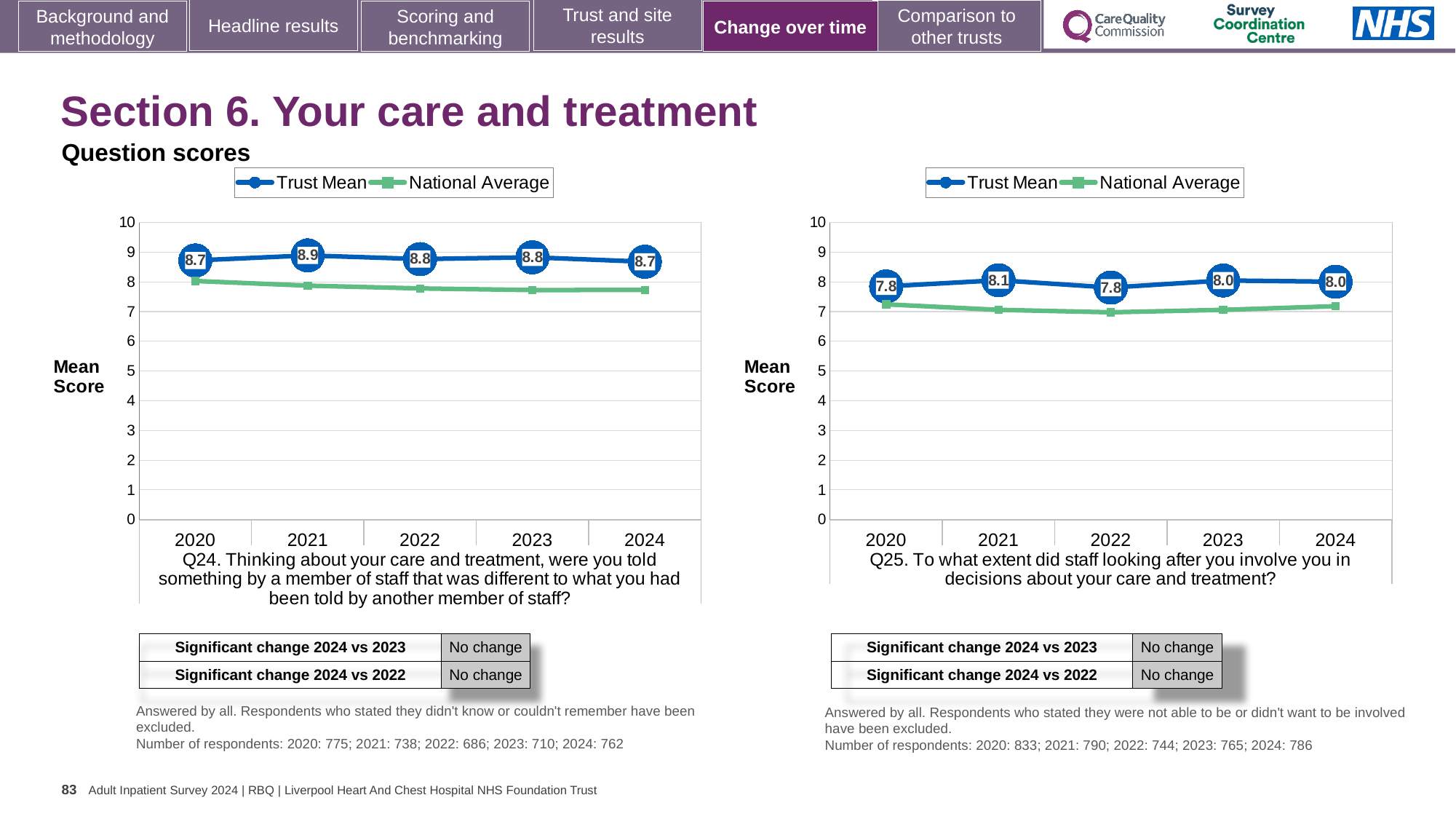
In the Q25 chart on the right, what is the difference between the Trust Mean scores for 2021 and 2020? 0.3 What kind of chart is the Q24 chart on the left? Line chart In the Q24 chart on the left, is the National Average value for 2024 greater or less than 8? less In the Q24 chart on the left, what is the Trust Mean score for 2021? 8.9 In the Q25 chart on the right, is the Trust Mean score higher in 2021 or in 2022? 2021 In the Q25 chart on the right, is the National Average value for 2024 greater or less than 8? less In the Q25 chart on the right, which year has the highest Trust Mean score? 2021 How many series does the legend of the Q25 chart on the right list? 2 In the Q24 chart on the left, which year has the highest Trust Mean score? 2021 In the Q24 chart on the left, what is the difference between the Trust Mean scores for 2021 and 2024? 0.2 In the Q25 chart on the right, what is the Trust Mean score for 2022? 7.8 How many years are plotted on the x axis of the Q24 chart on the left? 5